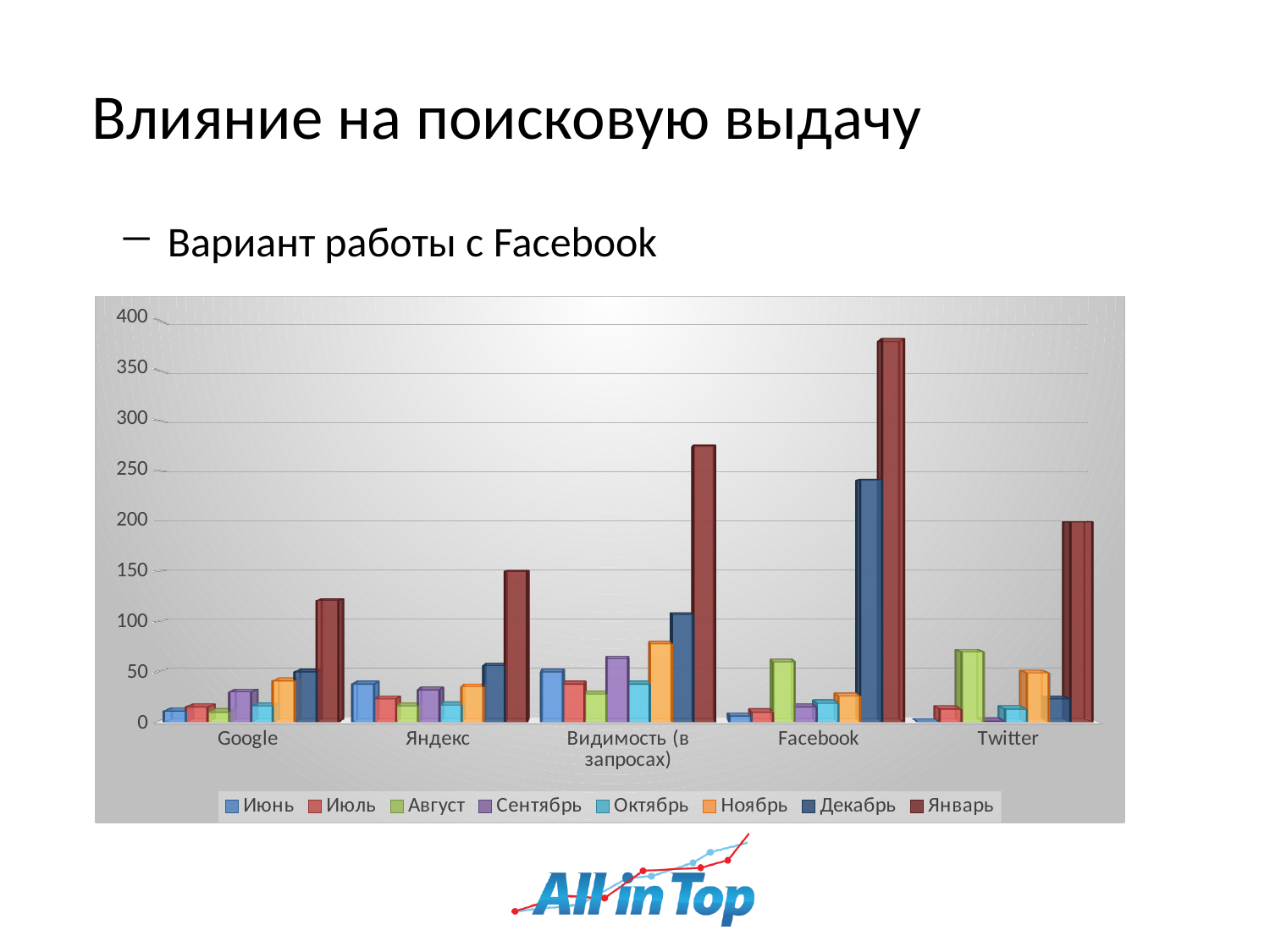
Which series is listed first in the chart legend? Июнь What kind of chart is shown on the slide? bar chart Is the Июнь value for Facebook greater or less than 50? less Is the Январь value for Facebook greater or less than 350? greater Which category has the highest value for the Январь series? Facebook Which category has the lowest value for the Январь series? Google Which is larger: the Ноябрь value for Google or the Ноябрь value for Видимость (в запросах)? Видимость (в запросах) How many series does the chart legend list? 8 Is the Январь value for Видимость (в запросах) greater or less than 250? greater How many categories are shown on the x axis of the chart? 5